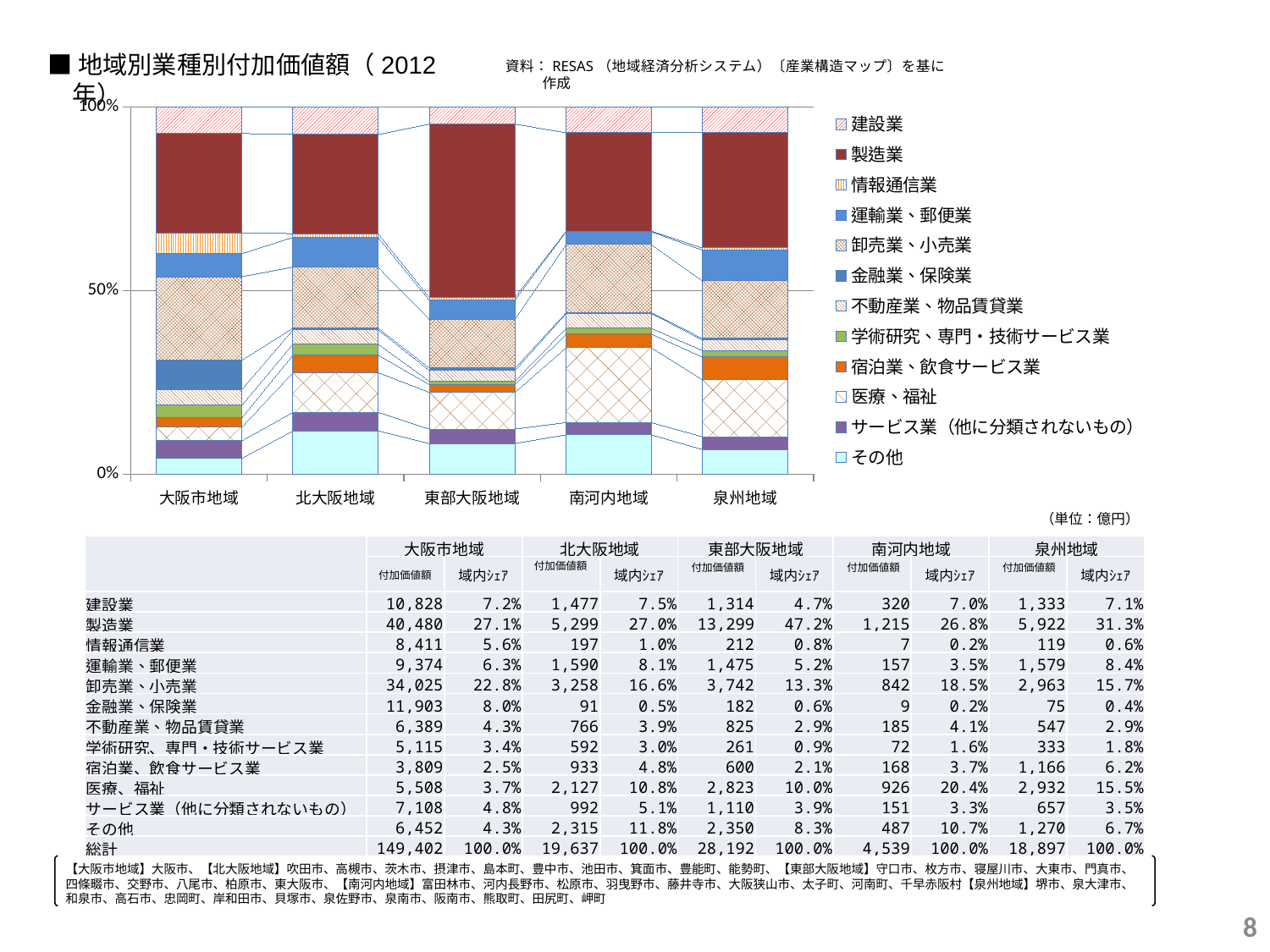
How many regions (categories) are plotted along the x axis of the chart? 5 What is the share of 医療、福祉 in 南河内地域? 20.4% Which series is listed first in the chart legend? 建設業 Is the share of 製造業 in 東部大阪地域 greater or less than 50%? less By how many percentage points does the share of 製造業 in 泉州地域 exceed that in 北大阪地域? 4.3% How many series does the chart legend list? 12 Which region has a larger share of 卸売業、小売業: 大阪市地域 or 泉州地域? 大阪市地域 What is the share (域内シェア) of 製造業 in 東部大阪地域? 47.2% Which region has the smallest share of 情報通信業? 南河内地域 What is the share of その他 in 北大阪地域? 11.8% What kind of chart is shown on the slide? Stacked bar chart Which region has the largest share of 製造業? 東部大阪地域